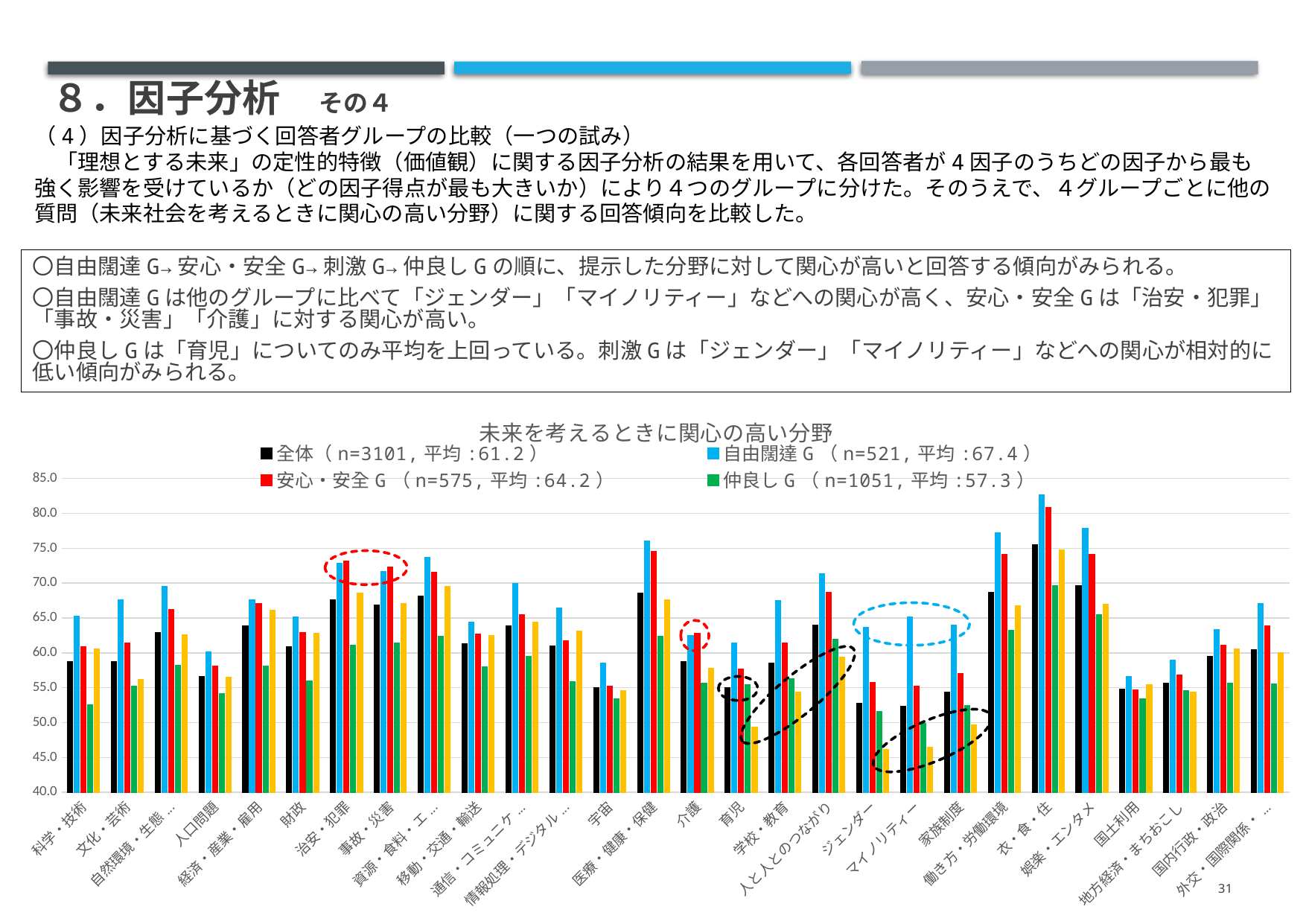
For which category is the 全体 bar the highest? 衣・食・住 For which category is the 仲良しG bar the lowest? マイノリティー Is the value for 仲良しG in 科学・技術 greater or less than 55.0? less Is the value for 自由闊達G in 宇宙 greater or less than 60.0? less How many categories are shown along the x axis of the chart? 28 How many series does the chart legend list? 4 For which category is the 自由闊達G bar the highest? 衣・食・住 According to the legend, what is the sample size (n) for 自由闊達G? n=521 What kind of chart is shown on the slide? bar chart For ジェンダー, which is larger: the 自由闊達G value or the 仲良しG value? 自由闊達G What is the title of the chart? 未来を考えるときに関心の高い分野 Is the value for 自由闊達G in 衣・食・住 greater or less than 80.0? greater